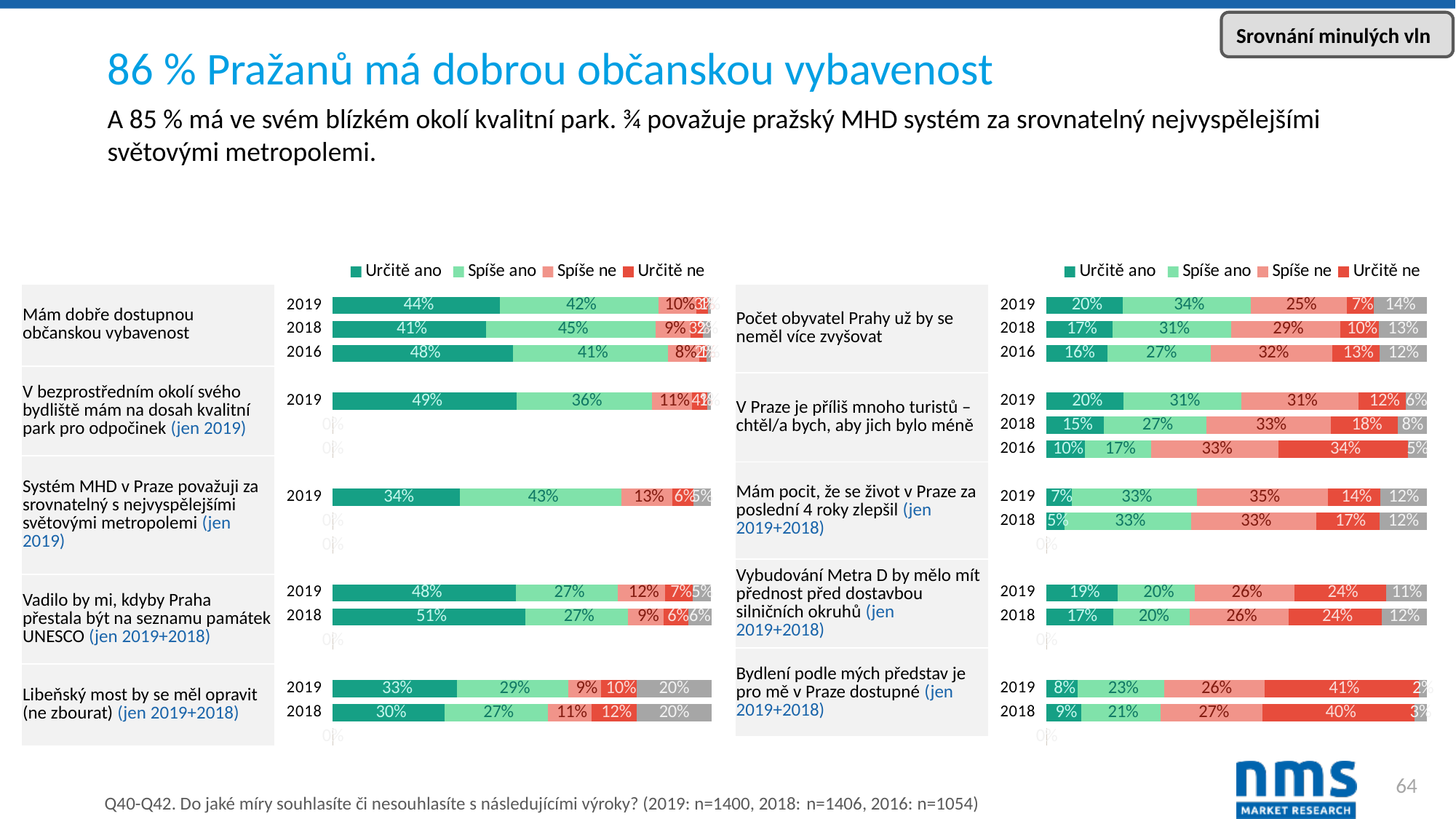
In the right chart, how does the 'Určitě ne' value for 'V Praze je příliš mnoho turistů' change from 2016 to 2019? It falls (34% to 18% to 12%) In the right chart, which is larger for 'Počet obyvatel Prahy už by se neměl více zvyšovat': the 'Spíše ano' value in 2019 or in 2016? 2019 In the left chart, what is the difference between the 'Určitě ano' values for 'Vadilo by mi, kdyby Praha přestala být na seznamu památek UNESCO' in 2018 and 2019? 3% In the right chart, what is the 'Určitě ne' value for 'Bydlení podle mých představ je pro mě v Praze dostupné' in 2019? 41% In the right chart, which year has the lowest 'Určitě ano' value for 'Mám pocit, že se život v Praze za poslední 4 roky zlepšil'? 2018 How many series does the legend of the left chart list? 4 In the left chart, what is the 'Určitě ano' value for 'Mám dobře dostupnou občanskou vybavenost' in 2019? 44% In the left chart, what is the 'Spíše ano' value for 'Systém MHD v Praze považuji za srovnatelný s nejvyspělejšími světovými metropolemi' in 2019? 43% In the left chart, what is the combined 'Určitě ano' and 'Spíše ano' value for 'Libeňský most by se měl opravit' in 2019? 62% What type of chart is used on the slide? Stacked bar chart In the left chart, which year has the highest 'Určitě ano' value for 'Mám dobře dostupnou občanskou vybavenost'? 2016 In the right chart, what is the 'Spíše ne' value for 'V Praze je příliš mnoho turistů' in 2016? 33%